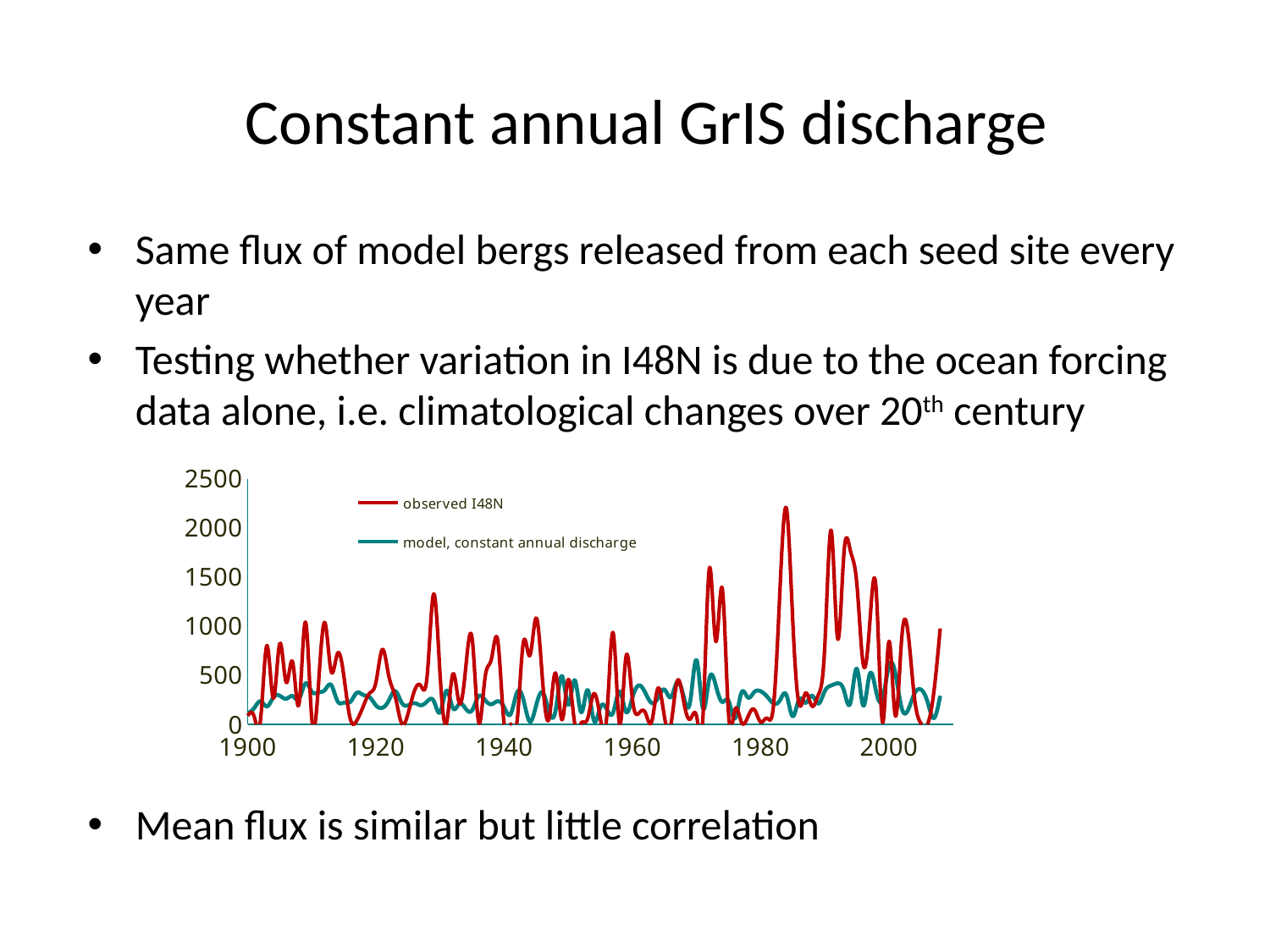
Which colour is used for the observed I48N series? red What is the highest value labelled on the vertical axis? 2500 What is the first year labelled on the horizontal axis? 1900 Is the highest peak of the observed I48N series greater or less than 2000? greater Is the observed I48N peak near 1929 greater or less than 1000? greater How many series does the chart legend list? 2 How many year labels are shown on the horizontal axis? 6 Around 1984, which series has the larger value, observed I48N or model, constant annual discharge? observed I48N Which series reaches the highest value on the chart? observed I48N What are the two series named in the chart legend? observed I48N; model, constant annual discharge What kind of chart is shown on the slide? line chart Is the highest value of the model, constant annual discharge series greater or less than 1000? less